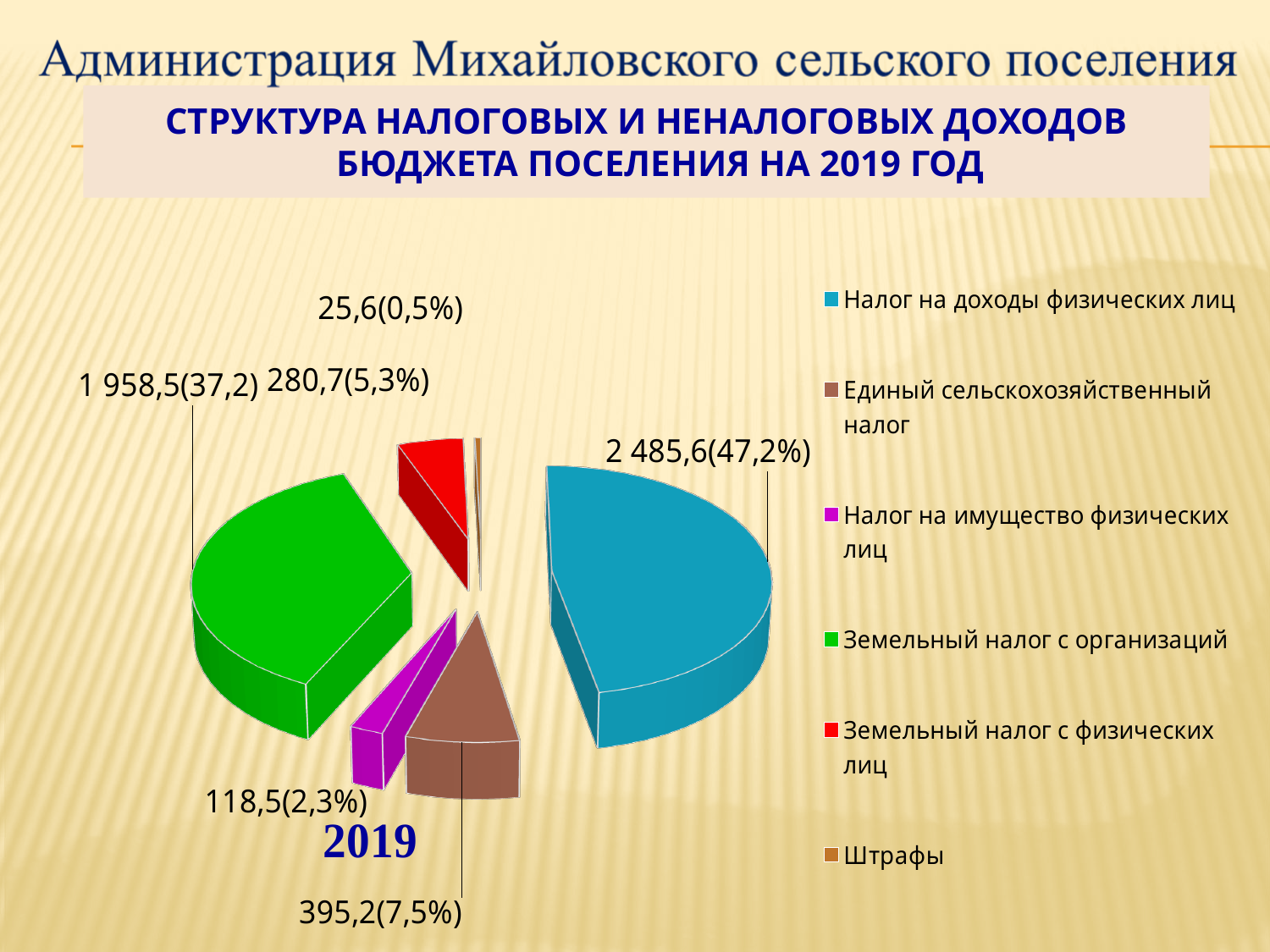
What value is labelled for Налог на доходы физических лиц? 2 485,6(47,2%) What kind of chart is shown on the slide? Pie chart What value is labelled for Земельный налог с организаций? 1 958,5(37,2) What share of the pie does Налог на имущество физических лиц take? 2,3% Which category has the smallest slice of the pie? Штрафы Which category has the largest slice of the pie? Налог на доходы физических лиц How many slices does the pie chart have? 6 How many entries does the legend list? 6 What value is labelled for Единый сельскохозяйственный налог? 395,2(7,5%) What value is labelled for Штрафы? 25,6(0,5%) What is the difference between the values for Налог на доходы физических лиц and Земельный налог с организаций? 527,1 Which is larger: Единый сельскохозяйственный налог or Земельный налог с физических лиц? Единый сельскохозяйственный налог